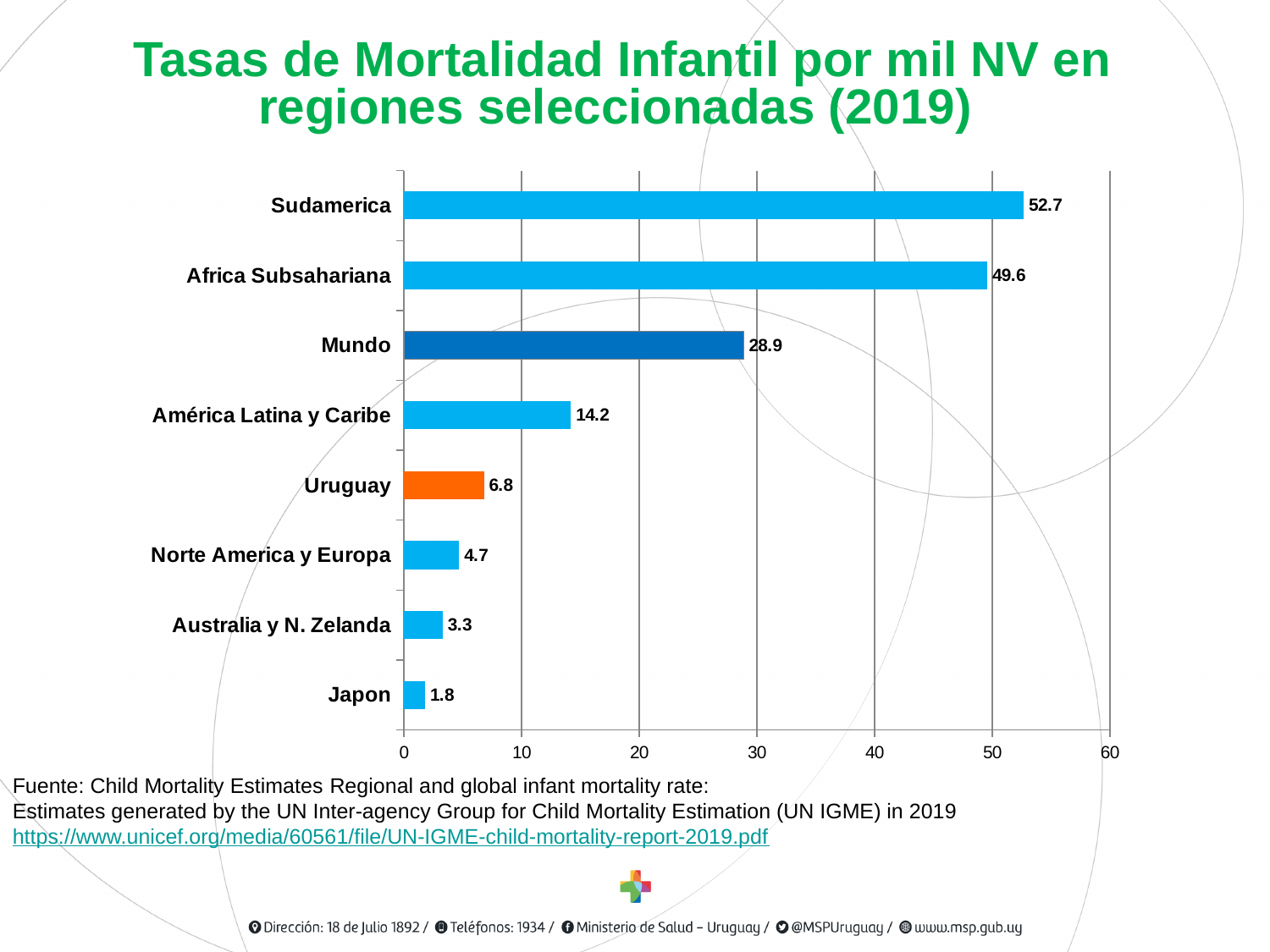
What is the value for América Latina y Caribe? 14.2 What is the infant mortality rate shown for Uruguay? 6.8 Which bar is coloured orange? Uruguay How many regions are shown on the chart? 8 Is the value for Africa Subsahariana greater or less than 40? greater Which region has the highest infant mortality rate on the chart? Sudamerica What value is shown for Mundo? 28.9 Which region has the lowest infant mortality rate on the chart? Japon What is the difference between the values for Uruguay and Norte America y Europa? 2.1 Which has a higher value, Mundo or América Latina y Caribe? Mundo What is the difference between the values for Sudamerica and Africa Subsahariana? 3.1 What type of chart is shown on the slide? Bar chart